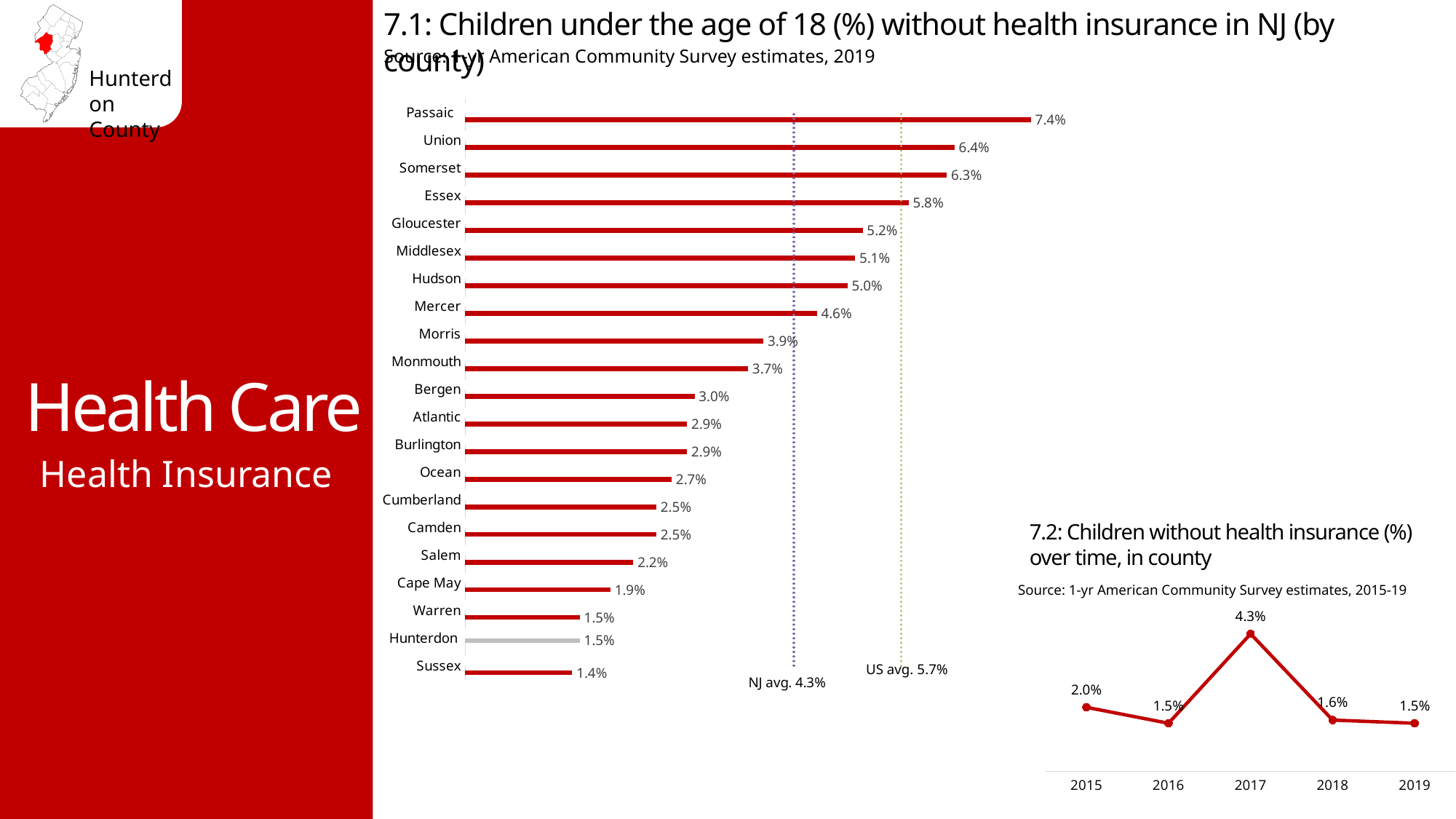
In chart 7.1, what is the NJ average shown by the dotted line? 4.3% In chart 7.1, which county has the lowest value? Sussex What kind of chart is chart 7.2? line chart In chart 7.1, what is the difference between Passaic and Sussex? 6.0% In chart 7.1, how many counties are plotted? 21 In chart 7.2, which year has the highest value? 2017 In chart 7.2, what is the value for 2017? 4.3% In chart 7.1, what is the value for Passaic? 7.4% In chart 7.1, what is the value for Hunterdon? 1.5% In chart 7.1, which is larger, the value for Mercer or the value for Morris? Mercer In chart 7.1, which county has the highest value? Passaic In chart 7.2, what is the difference between 2015 and 2016? 0.5%